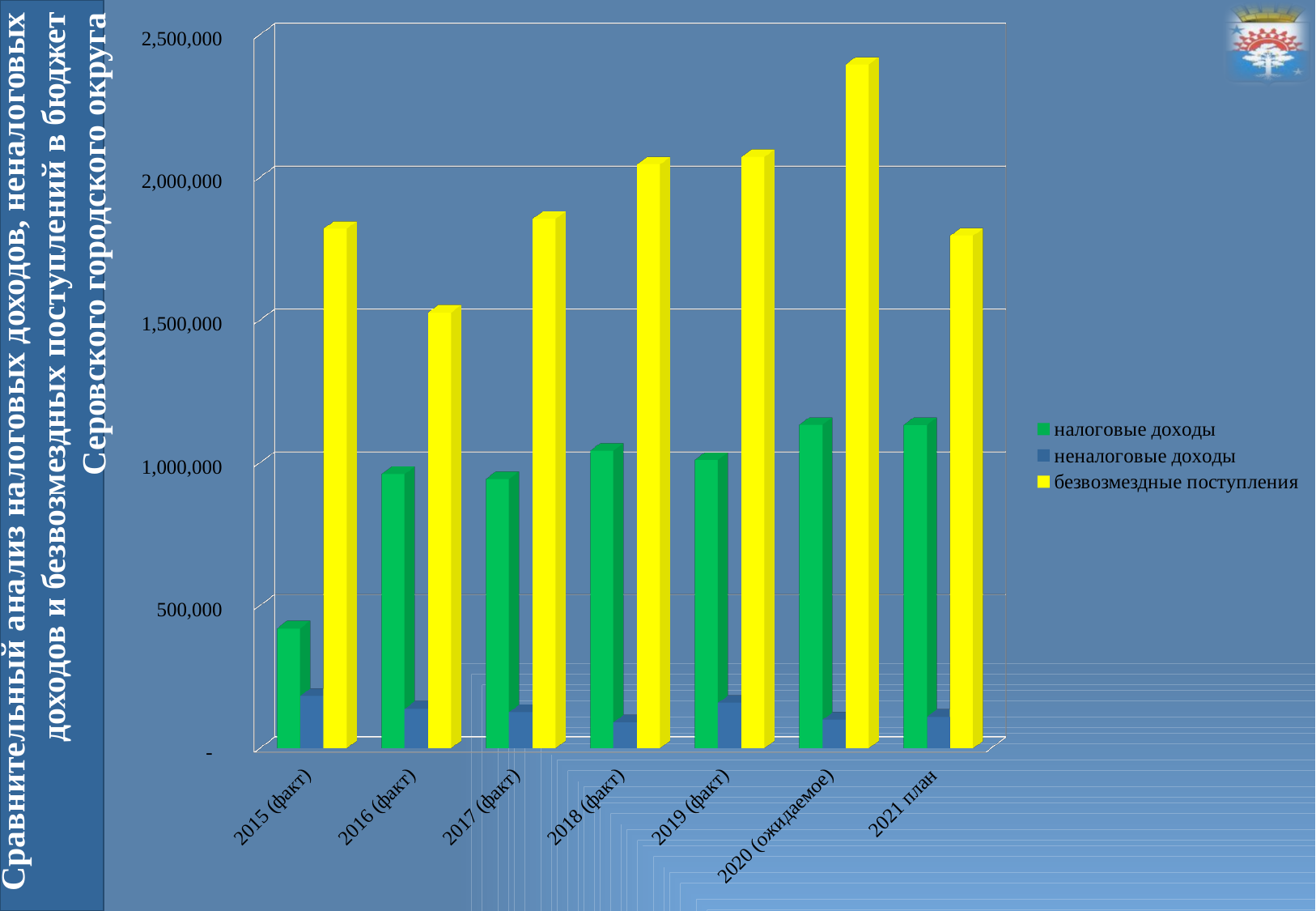
In which category is the value for налоговые доходы the lowest? 2015 (факт) What kind of chart is shown on the slide? bar chart Is the value for безвозмездные поступления in 2020 (ожидаемое) greater or less than 2,000,000? greater Which series has the larger value in 2015 (факт): налоговые доходы or безвозмездные поступления? безвозмездные поступления Which is larger: налоговые доходы in 2015 (факт) or in 2016 (факт)? 2016 (факт) Is the value for налоговые доходы in 2015 (факт) greater or less than 500,000? less How many series does the legend list? 3 Is the value for безвозмездные поступления in 2021 план greater or less than 2,000,000? less Which colour represents неналоговые доходы in the legend? blue How many categories (years) are shown on the x axis? 7 In which category is the value for безвозмездные поступления the lowest? 2016 (факт) In which category is the value for безвозмездные поступления the highest? 2020 (ожидаемое)